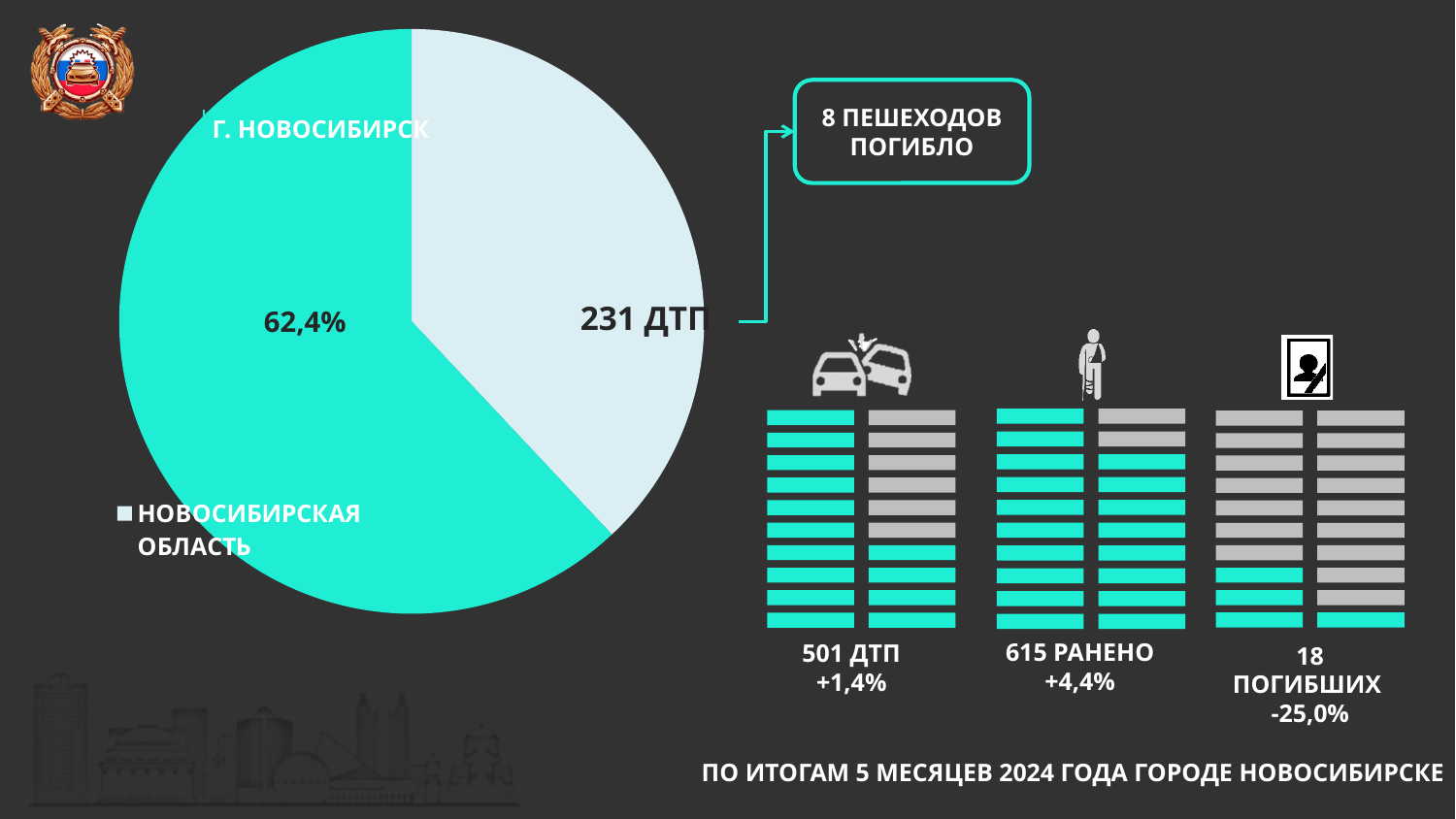
In the pictogram bars on the right, what value is printed for РАНЕНО? 615 Is the share of the Г. НОВОСИБИРСК slice in the pie chart greater or less than 50%? greater In the pictogram bars on the right, what value and change are printed under the car-crash icon? 501 ДТП +1,4% Which slice of the pie chart is the largest? Г. НОВОСИБИРСК In the pie chart, what value is printed on the НОВОСИБИРСКАЯ ОБЛАСТЬ slice? 231 ДТП In the pie chart, which is larger: the Г. НОВОСИБИРСК slice or the НОВОСИБИРСКАЯ ОБЛАСТЬ slice? Г. НОВОСИБИРСК Which slice of the pie chart is the smallest? НОВОСИБИРСКАЯ ОБЛАСТЬ What kind of chart is shown on the left of the slide? pie chart What colour is the Г. НОВОСИБИРСК slice in the pie chart? turquoise In the pie chart, what percentage is shown for Г. НОВОСИБИРСК? 62,4% How many slices does the pie chart have? 2 In the pictogram bars on the right, what percentage change is printed under 18 ПОГИБШИХ? -25,0%